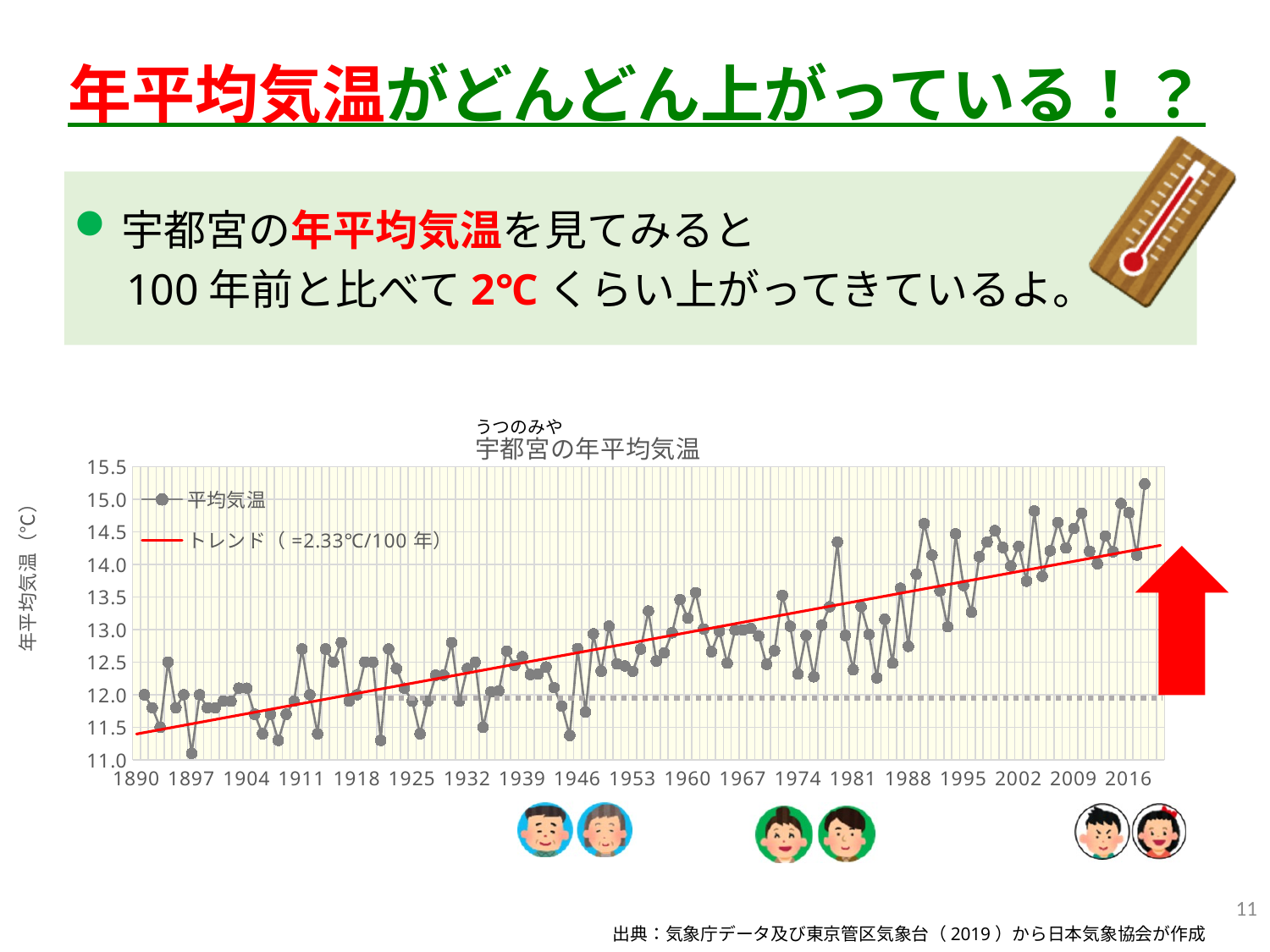
Is the lowest plotted value on the chart greater or less than 11.5? less What is the highest value shown on the y axis? 15.5 Is the highest plotted value on the chart greater or less than 15.0? greater Do the plotted annual mean temperatures generally rise or fall from 1890 to the right end of the x axis? rise How many series does the chart legend list? 2 What is the title of the chart? 宇都宮の年平均気温 What kind of chart is shown on the slide? line chart What are the two entries in the chart legend? 平均気温 and トレンド（=2.33℃/100年） How many year labels are printed along the x axis? 19 What rate of change does the trend line in the legend state? 2.33℃/100年 Is the plotted value for 1897 greater or less than 11.5? less What is the first year label on the x axis? 1890